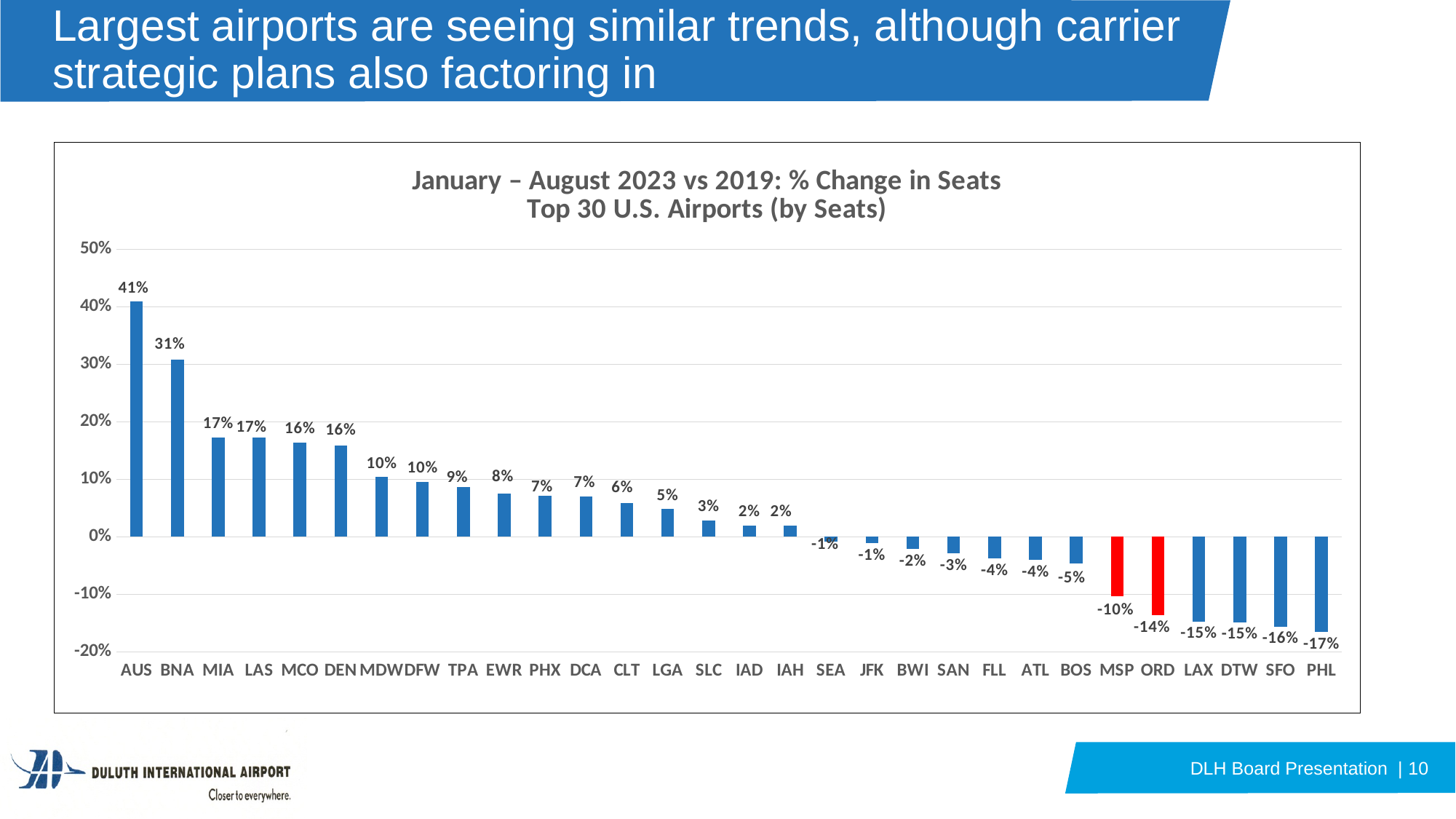
Do the values generally rise or fall moving from left to right along the x axis? Fall What is the % change in seats for DEN? 16% Which has a larger % change in seats, MDW or TPA? MDW What is the % change in seats for MSP? -10% Which two airports' bars are coloured red? MSP and ORD Which airport has the highest % change in seats? AUS What is the % change in seats for AUS? 41% Which airport has the lowest % change in seats? PHL What is the difference between the % change in seats for AUS and BNA? 10 percentage points How many airports are shown on the chart? 30 What is the % change in seats for ORD? -14% What kind of chart is shown on the slide? Bar chart